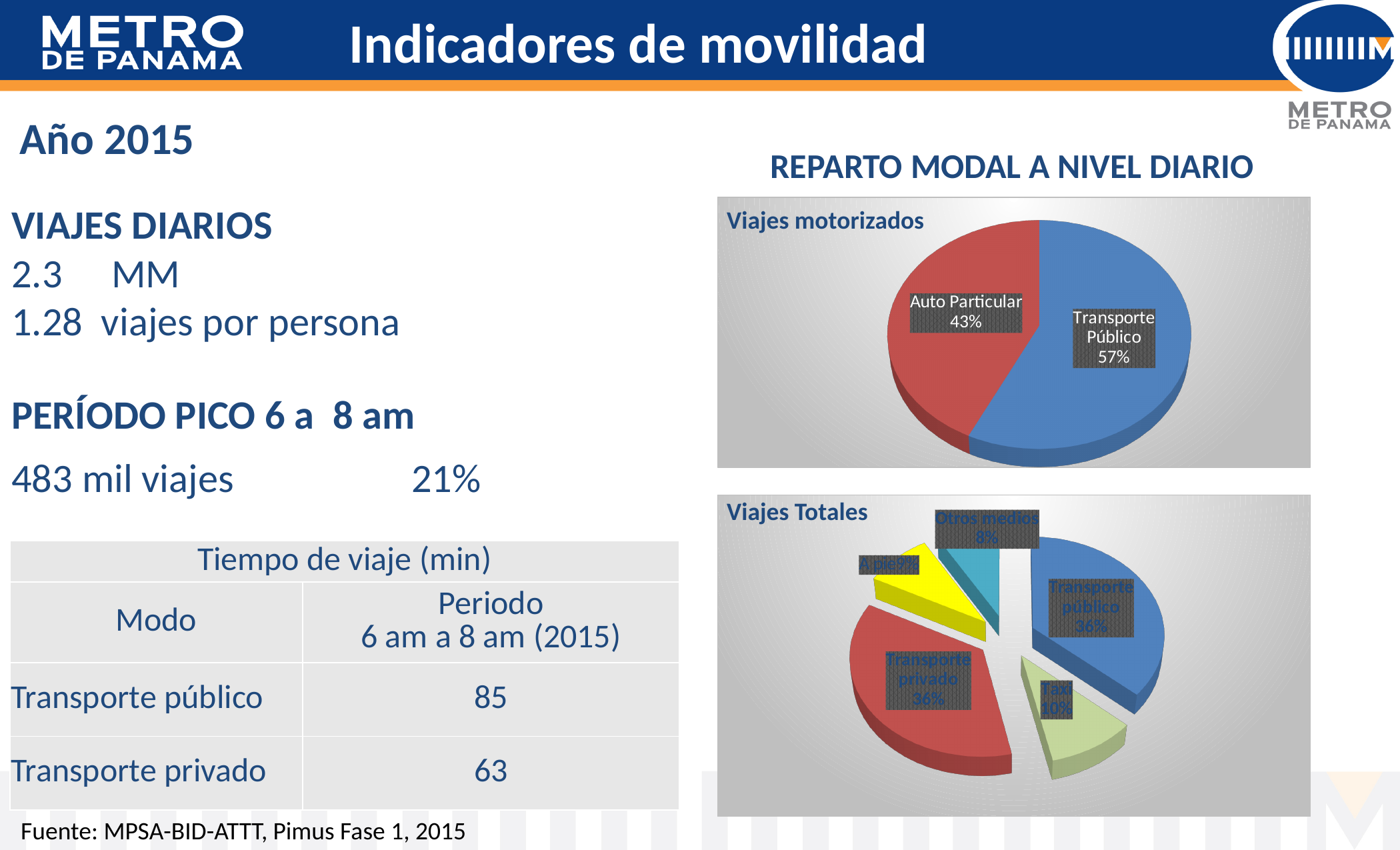
In the 'Viajes Totales' chart, which category has the smallest share? Otros medios How many categories does the 'Viajes motorizados' chart show? 2 In the 'Viajes Totales' chart, which is larger: Taxi or A pie? Taxi In the 'Viajes Totales' chart, what share of trips is Taxi? 10% In the 'Viajes motorizados' chart, what is the difference between the Transporte Público and Auto Particular shares? 14% In the 'Viajes motorizados' chart, which category has the larger share? Transporte Público In the 'Viajes motorizados' chart, what share of trips is Auto Particular? 43% What kind of chart is the 'Viajes motorizados' chart? Pie chart In the 'Viajes motorizados' chart, what share of trips is Transporte Público? 57% How many categories does the 'Viajes Totales' chart show? 5 In the 'Viajes Totales' chart, what share of trips is A pie? 9% In the 'Viajes Totales' chart, what share of trips is Otros medios? 8%